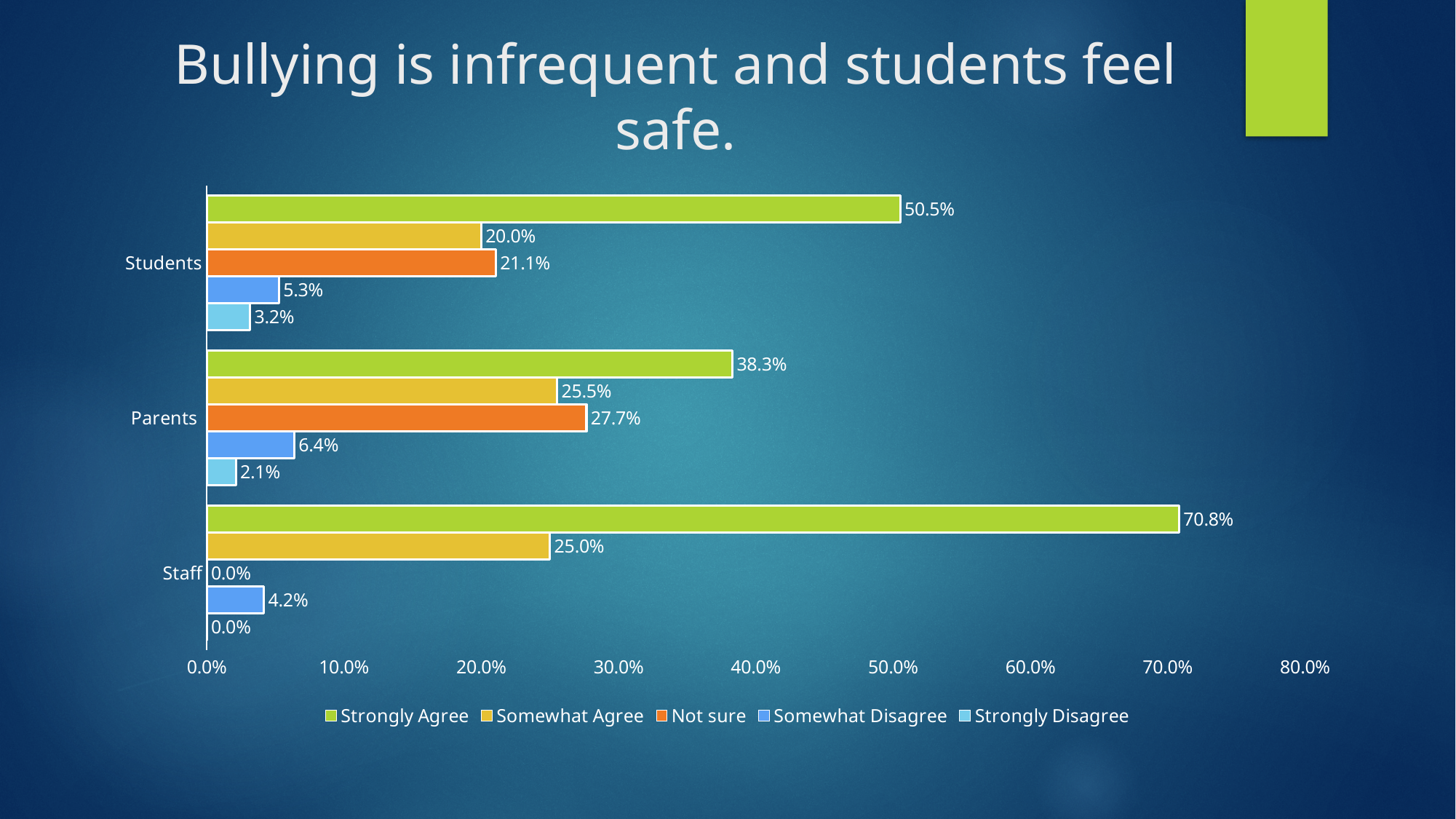
Which group has the lowest Strongly Disagree percentage? Staff What is the difference between the Strongly Agree values for Staff and Students? 20.3% What percentage of Students Strongly Agree that bullying is infrequent and students feel safe? 50.5% What is the Not sure value for Parents? 27.7% How many series does the legend list? 5 What kind of chart is shown on the slide? Bar chart Which group has the highest Strongly Agree percentage? Staff Which is larger for Parents: Somewhat Agree or Not sure? Not sure What is the title of the slide? Bullying is infrequent and students feel safe. How many groups are shown on the vertical axis? 3 What percentage of Staff Somewhat Disagree? 4.2% Is the Strongly Agree value for Staff greater or less than 60.0%? greater